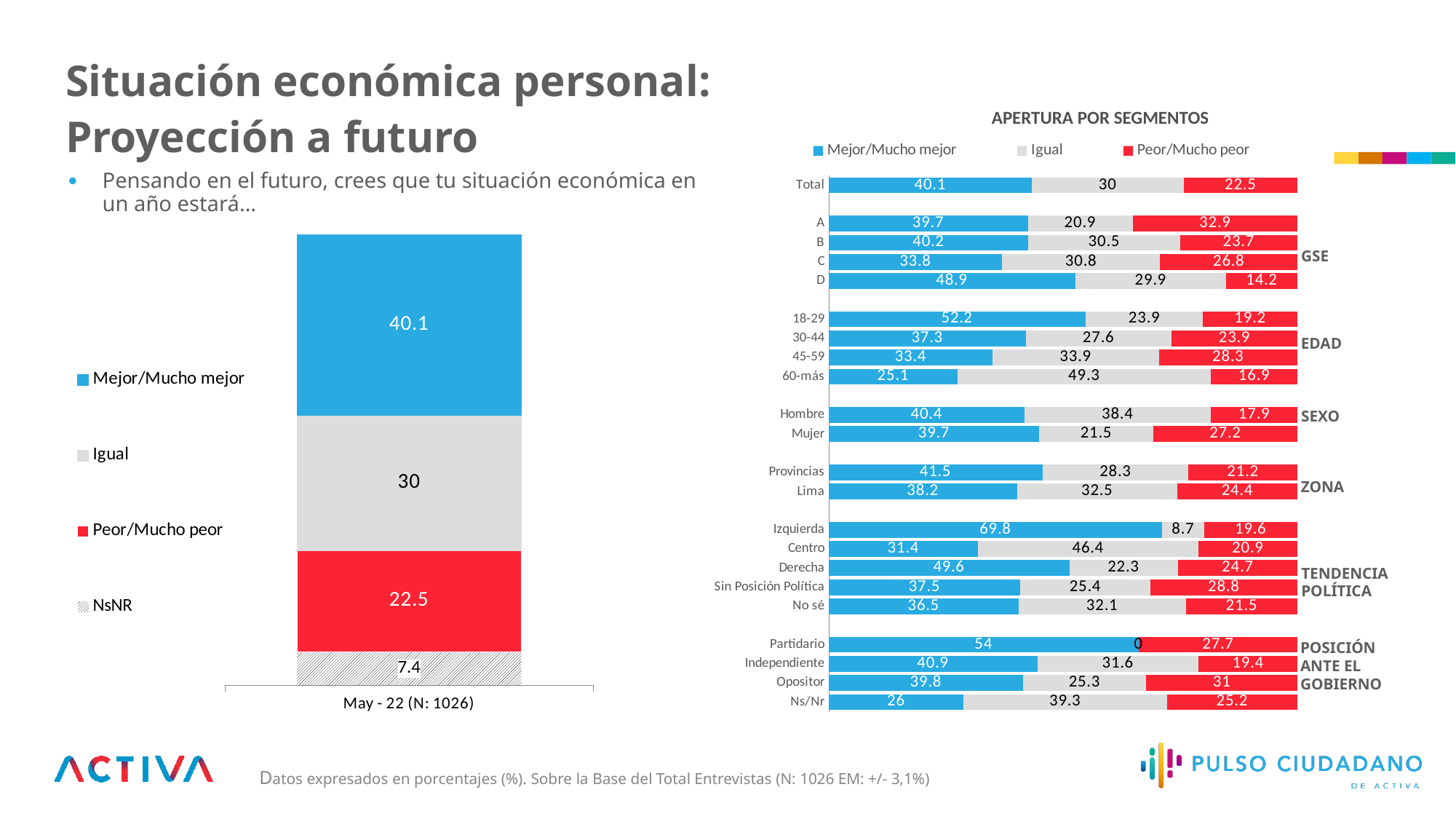
On the left chart (May - 22), what is the value for NsNR? 7.4 On the left chart (May - 22), what is the value for Mejor/Mucho mejor? 40.1 What kind of chart is the APERTURA POR SEGMENTOS chart? Bar chart On the APERTURA POR SEGMENTOS chart, which segment has the highest Peor/Mucho peor value? A On the APERTURA POR SEGMENTOS chart, which has the larger Igual value, Hombre or Mujer? Hombre On the left chart (May - 22), which segment is the largest? Mejor/Mucho mejor On the APERTURA POR SEGMENTOS chart, what is the Igual value for 60-más? 49.3 On the left chart (May - 22), how many series does the legend list? 4 On the APERTURA POR SEGMENTOS chart, what is the Mejor/Mucho mejor value for Izquierda? 69.8 On the APERTURA POR SEGMENTOS chart, what is the difference between the Mejor/Mucho mejor values for 18-29 and 60-más? 27.1 On the APERTURA POR SEGMENTOS chart, which segment has the lowest Mejor/Mucho mejor value? 60-más On the APERTURA POR SEGMENTOS chart, how many series does the legend list? 3